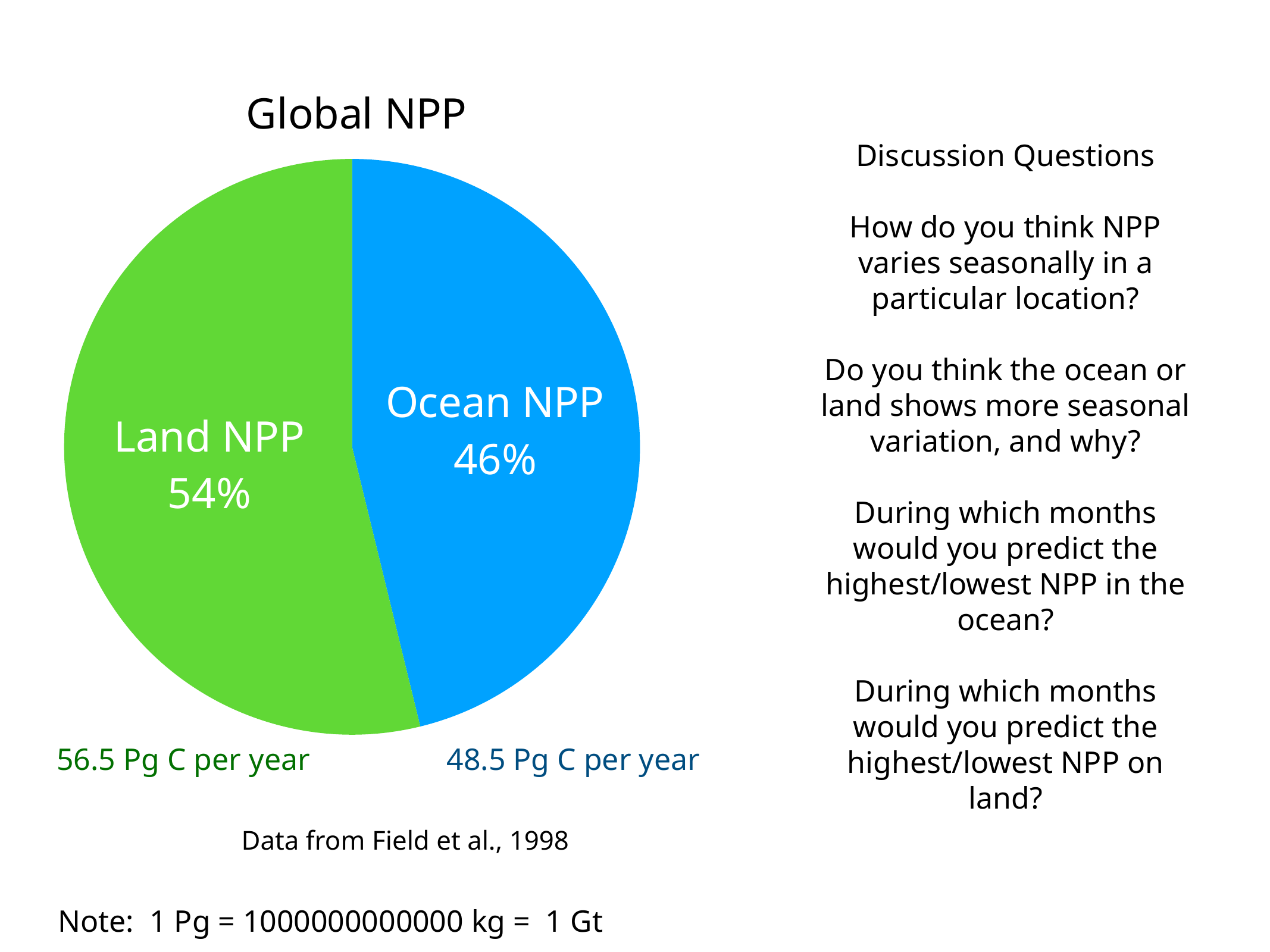
What is the difference in percentage points between the Land NPP and Ocean NPP shares? 8% What value in Pg C per year is given for Ocean NPP? 48.5 Pg C per year How many slices does the pie chart have? 2 Which category has the smallest share of global NPP? Ocean NPP What is the title of the chart? Global NPP Which slice is larger, Land NPP or Ocean NPP? Land NPP What is the difference between the Land NPP and Ocean NPP values in Pg C per year? 8 Pg C per year What percentage of global NPP does Ocean NPP account for? 46% What colour is the Ocean NPP slice? blue What percentage of global NPP does Land NPP account for? 54% What value in Pg C per year is given for Land NPP? 56.5 Pg C per year What type of chart is shown on the slide? pie chart